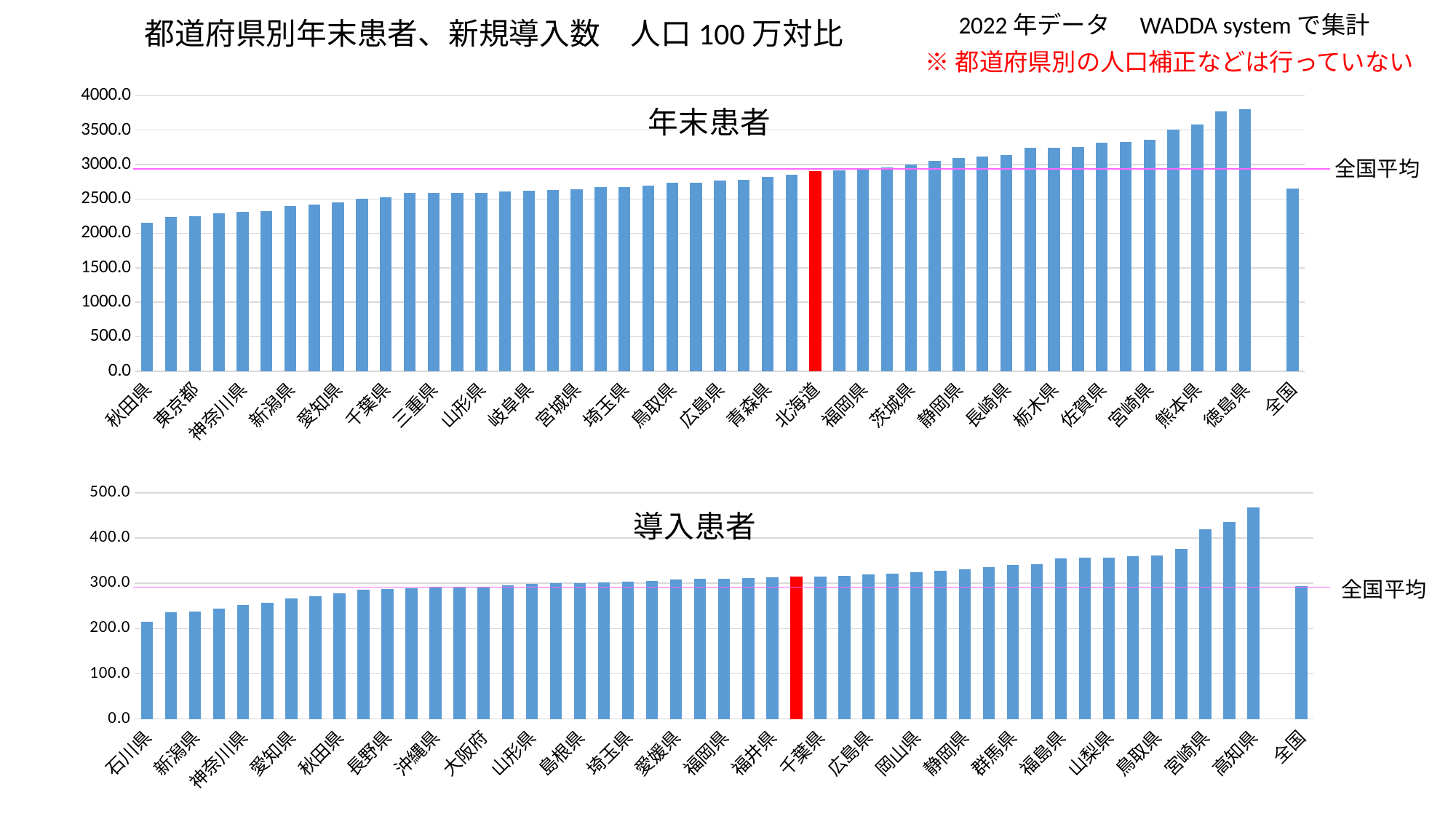
In the top chart (年末患者), which labeled prefecture has the tallest bar? 徳島県 What kind of chart is the top chart titled 年末患者? bar chart In the bottom chart (導入患者), which labeled prefecture has the tallest bar? 高知県 In the top chart (年末患者), which labeled prefecture has the shortest bar? 秋田県 In the bottom chart (導入患者), is the value for 秋田県 greater or less than 300? less In the top chart (年末患者), is the value for 秋田県 greater or less than 2500? less In the bottom chart (導入患者), do the prefecture bars rise or fall from left to right? rise In the top chart (年末患者), is the value for 宮崎県 greater or less than 3000? greater In the bottom chart (導入患者), which labeled prefecture has the shortest bar? 石川県 In the top chart (年末患者), which prefecture's bar is drawn in red? 北海道